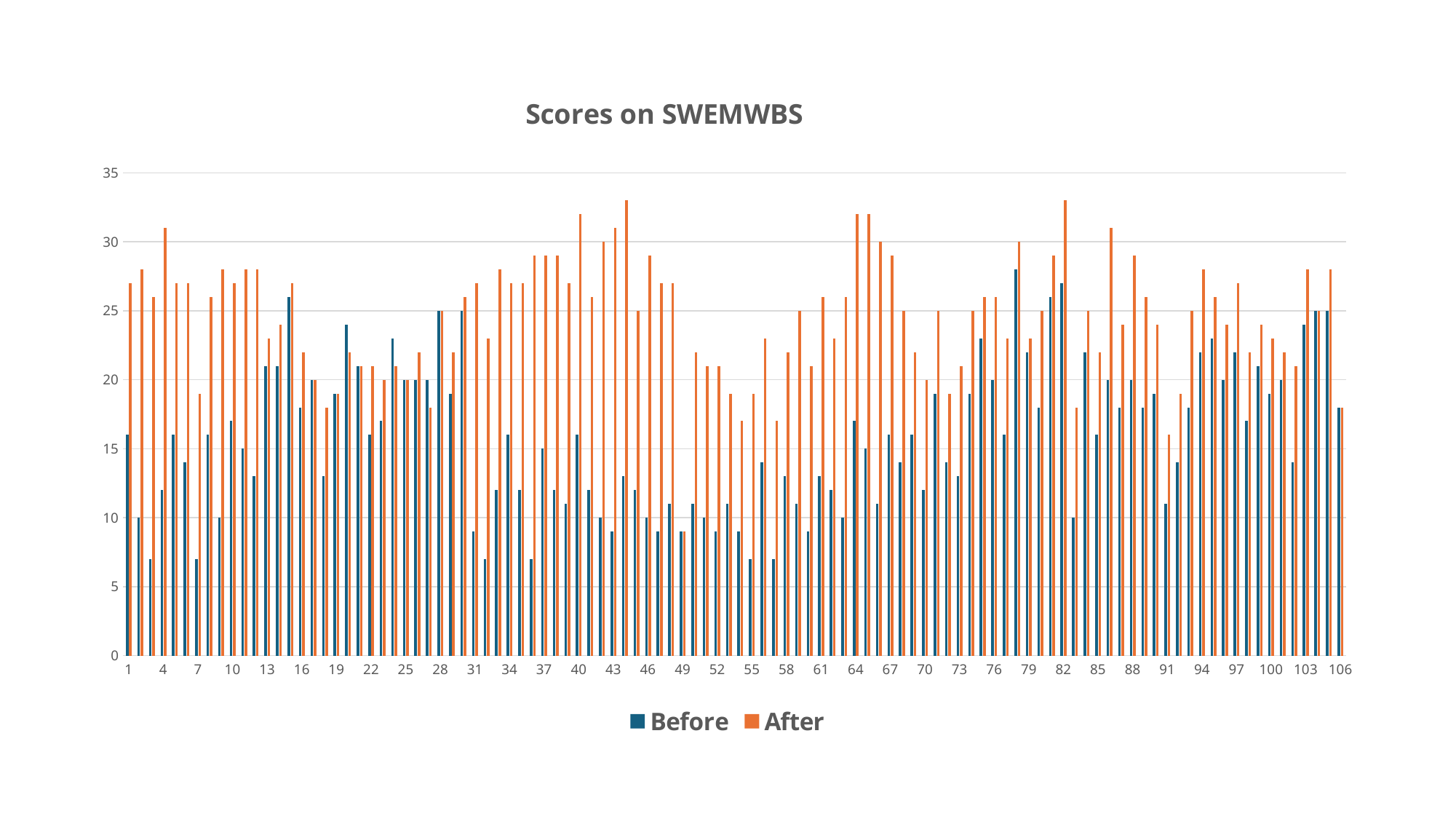
Is the After value for category 83 greater or less than 30? less For category 44, which is larger, the Before value or the After value? After How many series does the legend list? 2 How many categories are shown along the x axis? 106 Is the Before value for category 78 greater or less than 25? greater Is the Before value for category 20 greater or less than 20? greater What are the two series named in the legend? Before and After What is the title of the chart? Scores on SWEMWBS What kind of chart is shown on the slide? bar chart For category 1, which is larger, the Before value or the After value? After